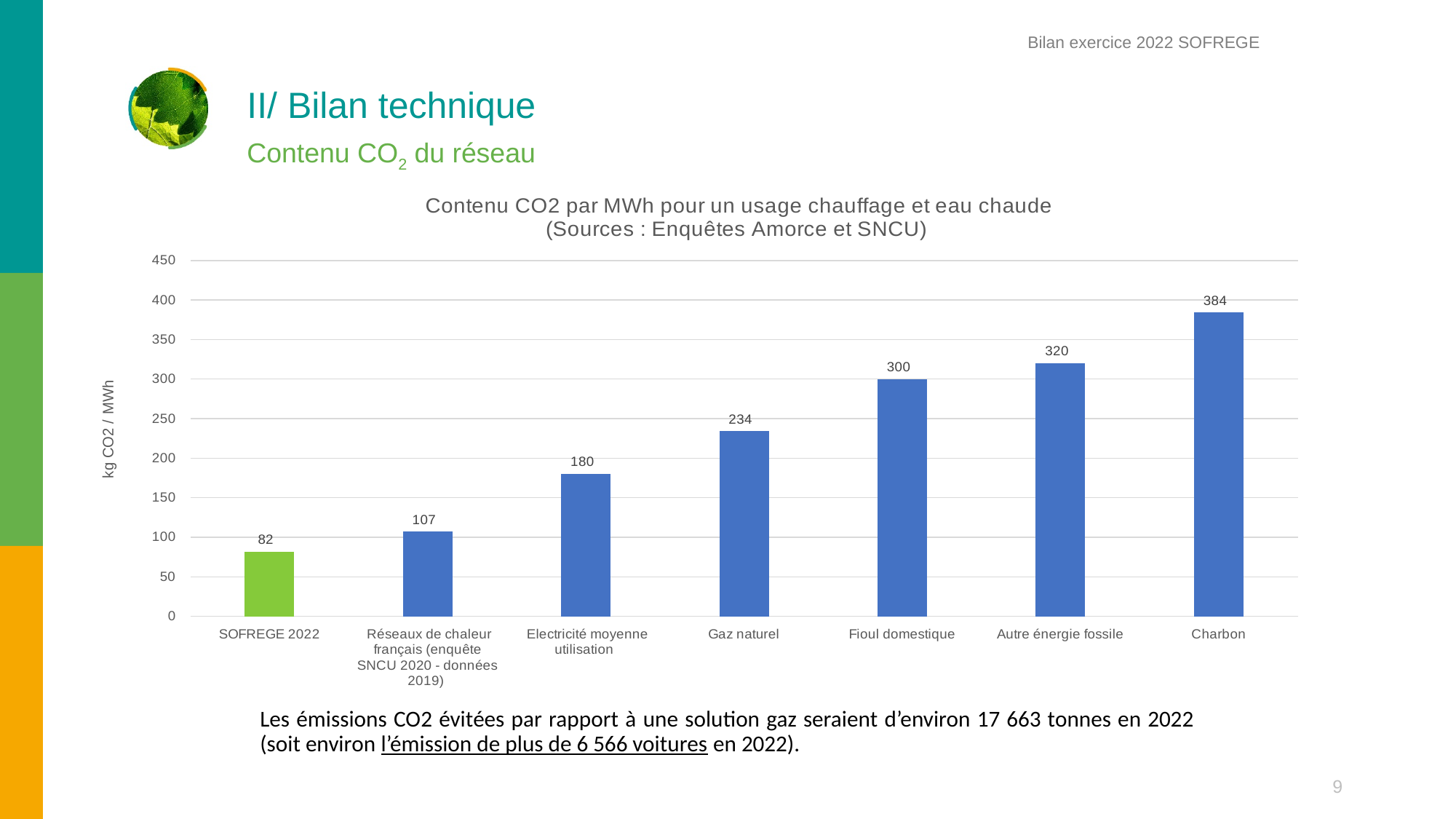
Which category has the highest value? Charbon Which is larger, the value for Autre énergie fossile or the value for Fioul domestique? Autre énergie fossile Do the values rise or fall from left to right along the x axis? Rise What is the value for Fioul domestique? 300 What kind of chart is shown on the slide? Bar chart Which category has the lowest value? SOFREGE 2022 How many categories are shown on the x axis? 7 What is the value for Gaz naturel? 234 What is the value for Electricité moyenne utilisation? 180 What is the difference between the values for Charbon and SOFREGE 2022? 302 What is the value for SOFREGE 2022? 82 What is the label of the vertical axis? kg CO2 / MWh